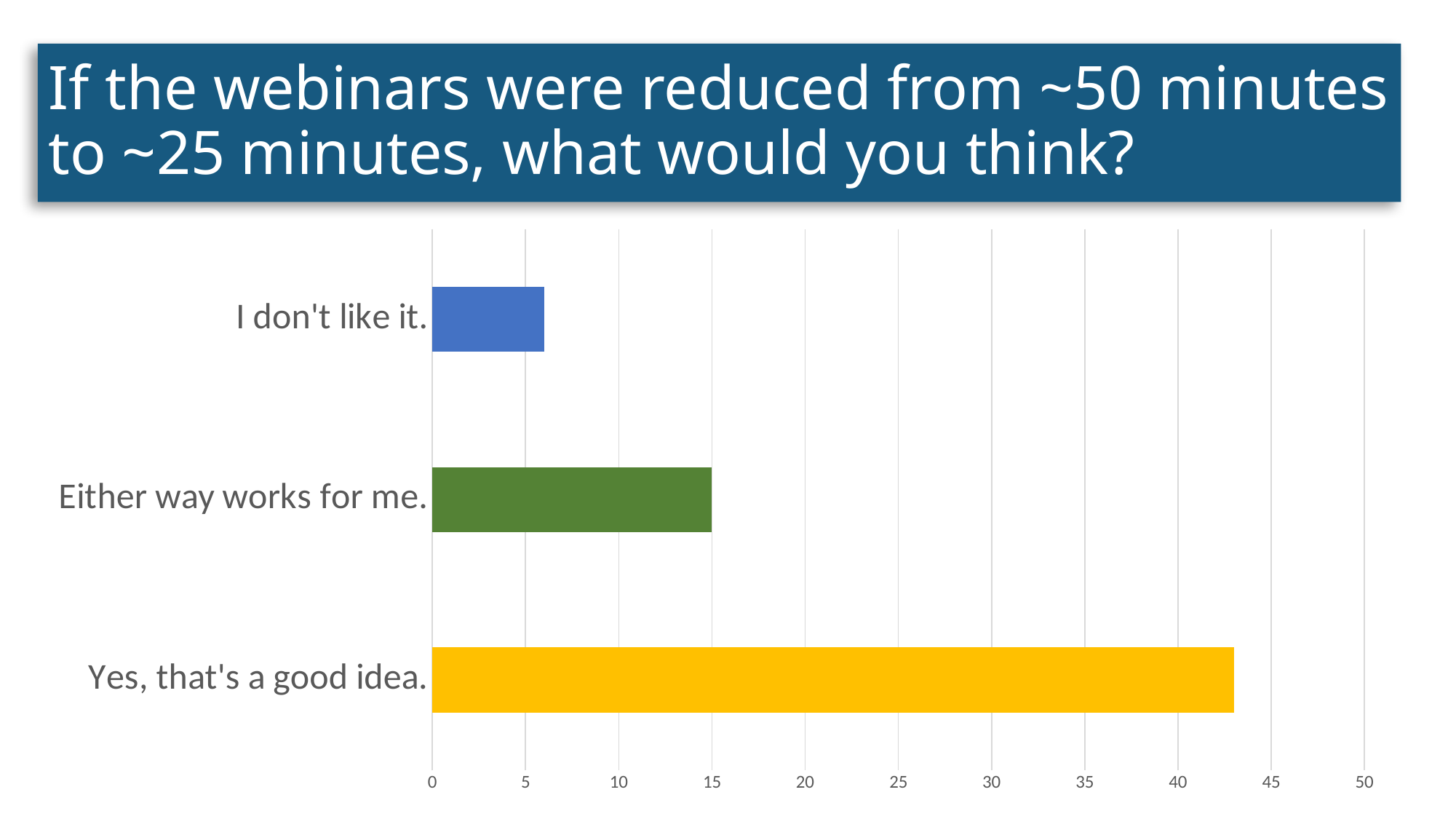
What is the title of the slide containing the chart? If the webinars were reduced from ~50 minutes to ~25 minutes, what would you think? What is the value for "Either way works for me."? 15 Is the value for "I don't like it." greater or less than 10? less Which is larger, the value for "Either way works for me." or the value for "I don't like it."? Either way works for me. Which is larger, the value for "Yes, that's a good idea." or the value for "Either way works for me."? Yes, that's a good idea. Is the value for "Yes, that's a good idea." greater or less than 45? less Is the value for "Yes, that's a good idea." greater or less than 40? greater What colour is the bar for "Yes, that's a good idea."? Yellow Which category has the lowest value? I don't like it. What type of chart is shown on the slide? Bar chart Which category has the highest value? Yes, that's a good idea. How many categories are shown in the chart? 3